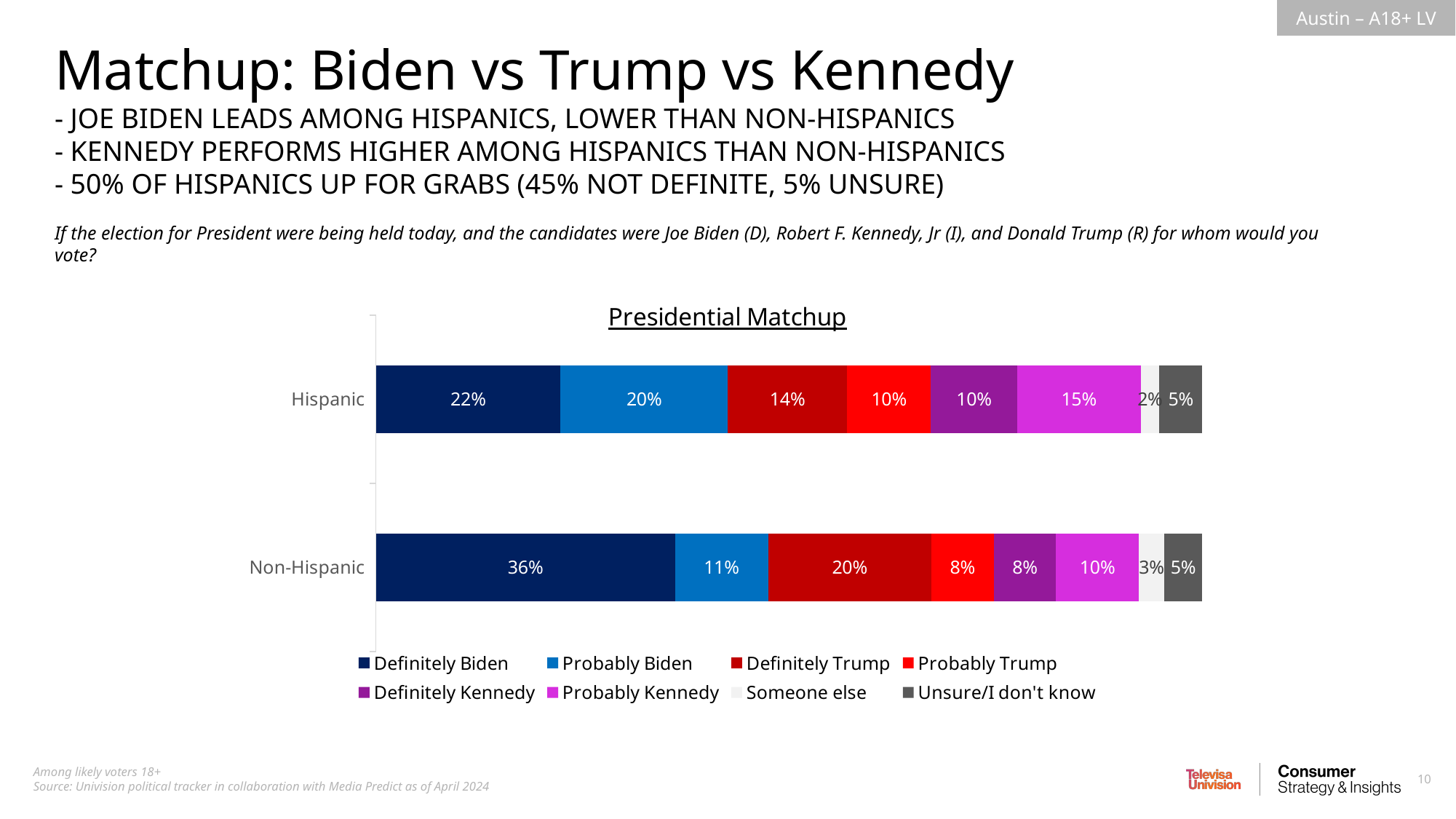
What is the difference between the Definitely Biden values for Non-Hispanic and Hispanic? 14% How many categories are shown in the Presidential Matchup chart? 2 What is the Definitely Trump value for Non-Hispanic in the Presidential Matchup chart? 20% How many series does the legend list in the Presidential Matchup chart? 8 What is the difference between the Probably Kennedy values for Hispanic and Non-Hispanic? 5% What is the Definitely Biden value for Hispanic in the Presidential Matchup chart? 22% Which series has the smallest value in the Hispanic bar? Someone else Which category has the higher Definitely Biden value, Hispanic or Non-Hispanic? Non-Hispanic What kind of chart is the Presidential Matchup chart? Stacked bar chart What is the Probably Kennedy value for Hispanic in the Presidential Matchup chart? 15% What is the Someone else value for Non-Hispanic in the Presidential Matchup chart? 3% Which series has the largest value in the Hispanic bar? Definitely Biden